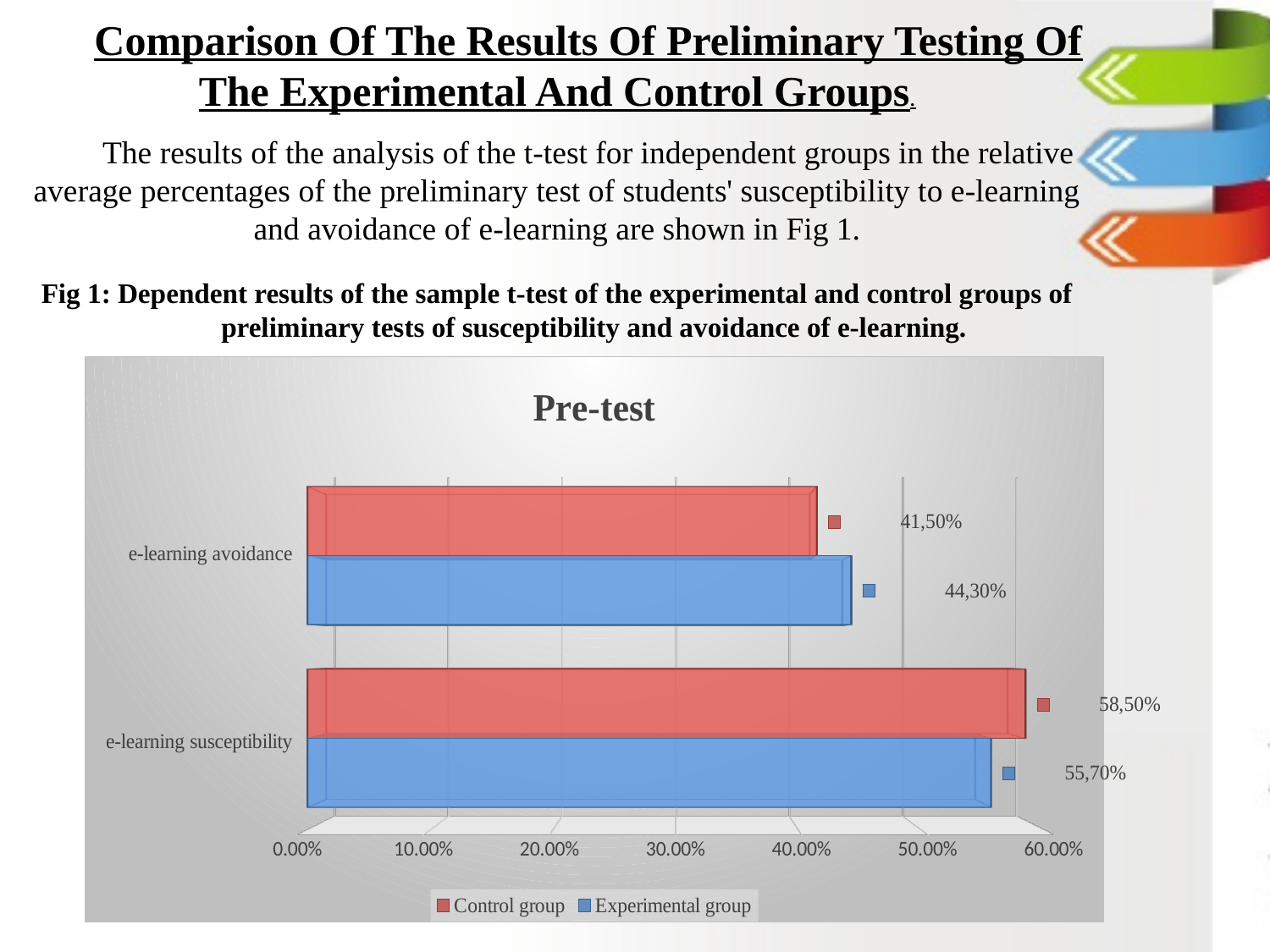
What is the chart title? Pre-test What is the value for the Experimental group for e-learning avoidance? 44,30% What is the value for the Control group for e-learning susceptibility? 58,50% What is the difference between the Control group and Experimental group values for e-learning susceptibility? 2,80% How many series does the legend list? 2 What is the value for the Control group for e-learning avoidance? 41,50% Which group has the higher value for e-learning avoidance? Experimental group What type of chart is shown on the slide? bar chart Which colour represents the Control group in the legend? red How many categories are shown on the chart? 2 Which group has the higher value for e-learning susceptibility? Control group What is the value for the Experimental group for e-learning susceptibility? 55,70%